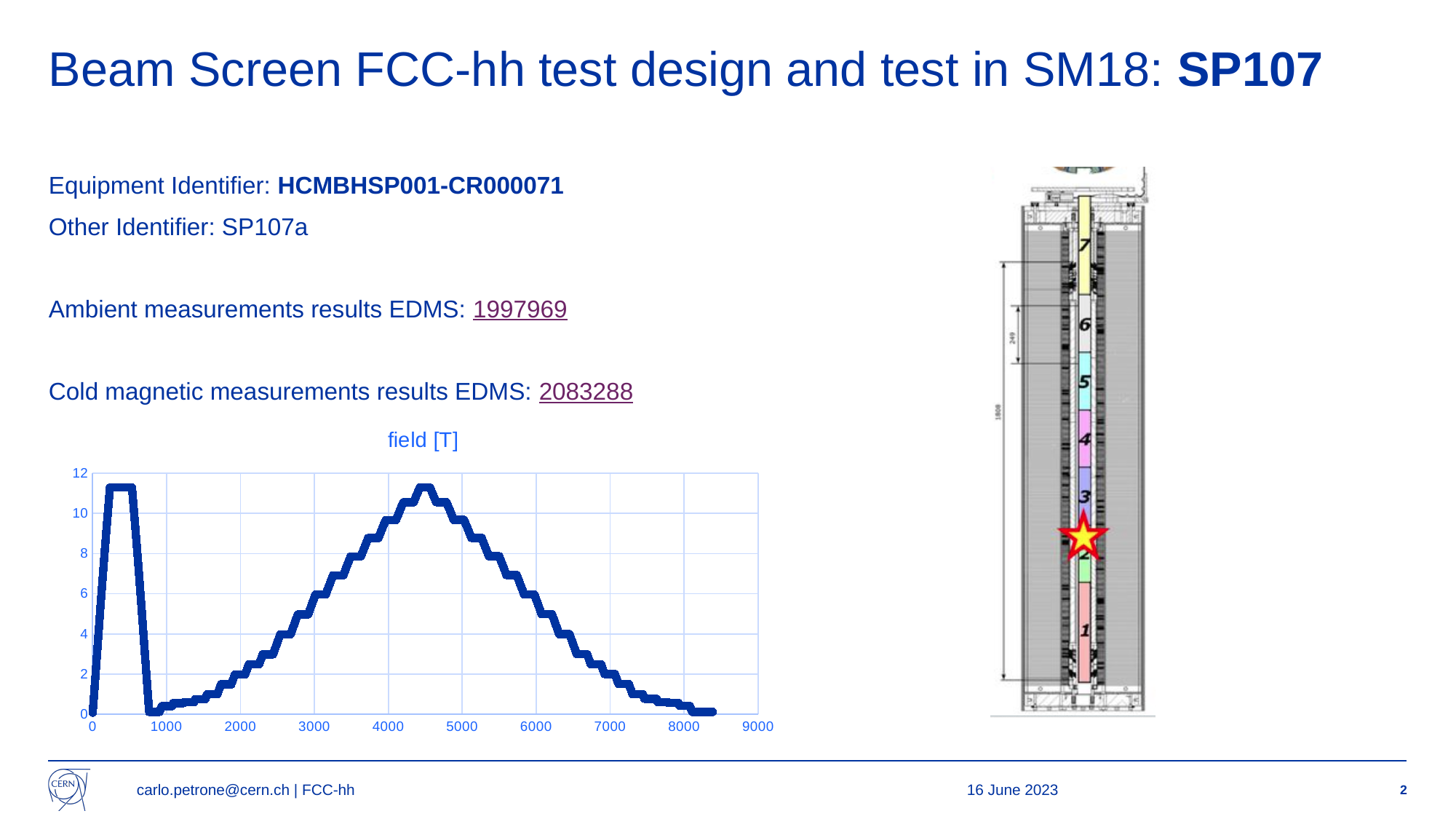
Is the value of the field at x = 3000 greater or less than 4? greater What is the highest value shown on the chart's y axis? 12 Is the value of the field at x = 2000 greater or less than 4? less Is the value of the field at x = 4500 greater or less than 10? greater How many data series are plotted in the chart? 1 Is the field value at x = 4500 greater or less than the field value at x = 6000? greater Between x = 4500 and x = 8000, does the field value rise or fall? fall Between x = 1000 and x = 4500, does the field value rise or fall? rise What is the title of the chart on the slide? field [T] What kind of chart is shown on the slide? line chart